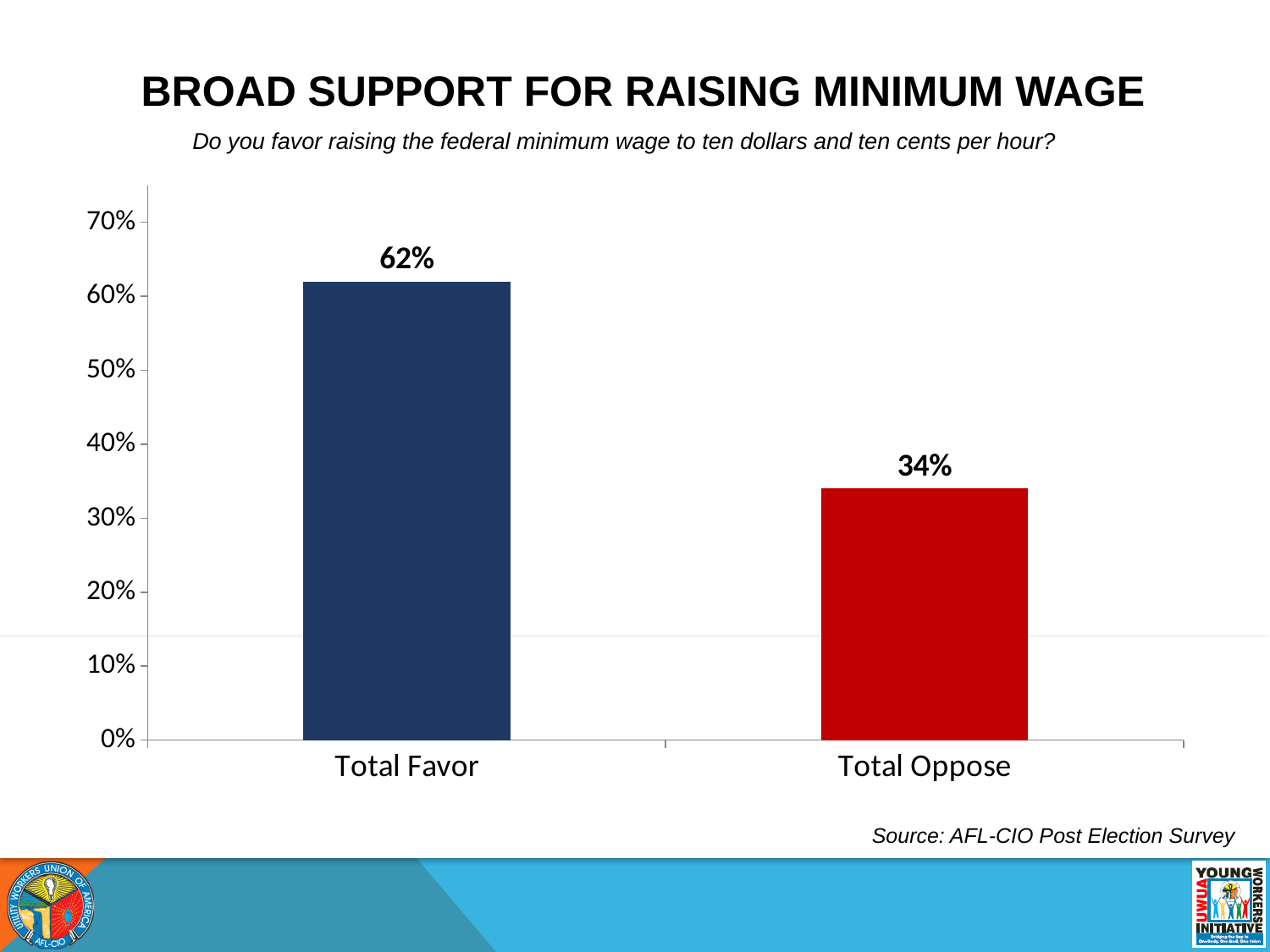
What colour is the Total Oppose bar? Red Is the value for Total Favor greater or less than 50%? greater Which is larger, Total Favor or Total Oppose? Total Favor What percentage is shown for Total Favor? 62% Is the value for Total Oppose greater or less than 40%? less What kind of chart is shown on the slide? Bar chart Which category has the highest value? Total Favor What is the difference between Total Favor and Total Oppose? 28% Which category has the lowest value? Total Oppose What percentage is shown for Total Oppose? 34% How many categories are shown on the chart? 2 What is the title of the slide? BROAD SUPPORT FOR RAISING MINIMUM WAGE